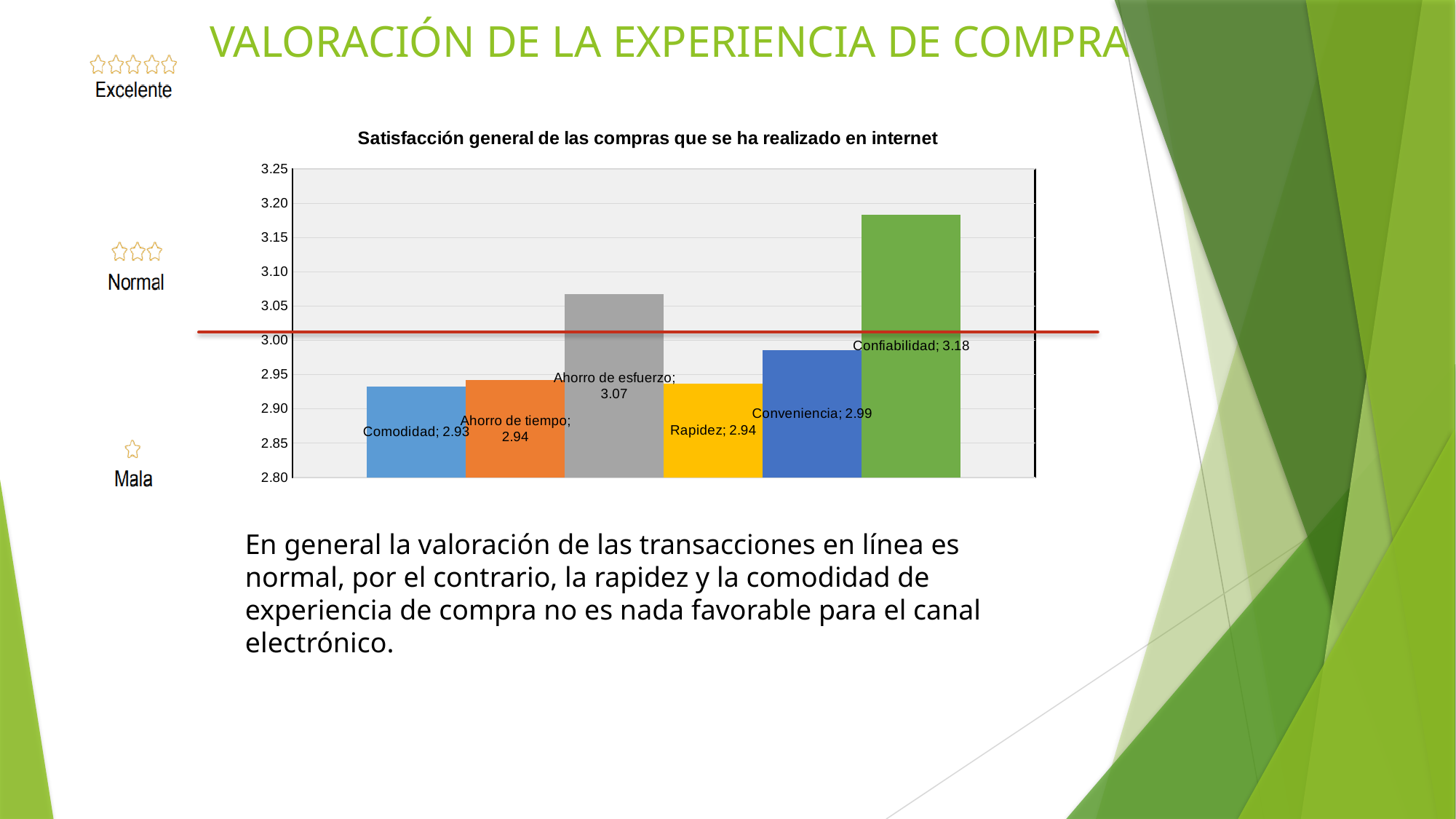
What is the value for Comodidad? 2.93 Is the value for Rapidez greater or less than 3.00? less How many categories are shown in the chart? 6 Which category has the highest value? Confiabilidad What is the value for Confiabilidad? 3.18 What kind of chart is shown on the slide? bar chart Which category has the lowest value? Comodidad What is the value for Ahorro de esfuerzo? 3.07 What is the value for Conveniencia? 2.99 Which is larger, the value for Ahorro de esfuerzo or the value for Conveniencia? Ahorro de esfuerzo What is the difference between the values for Confiabilidad and Ahorro de esfuerzo? 0.11 What is the difference between the values for Confiabilidad and Comodidad? 0.25